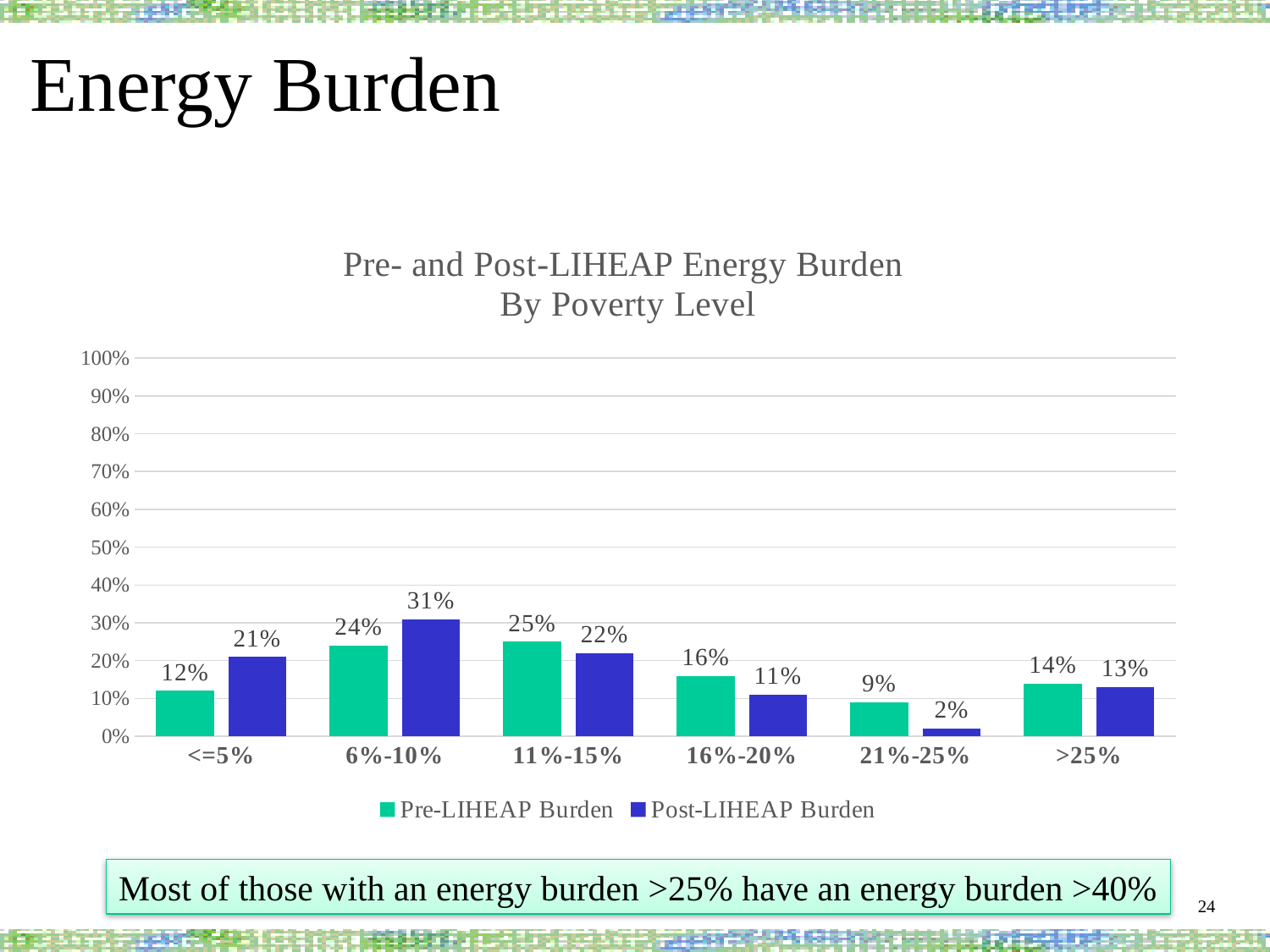
What is the Pre-LIHEAP Burden value for the <=5% category? 12% How many poverty level categories are shown on the x axis? 6 What colour are the Post-LIHEAP Burden bars? Blue Which is larger for the 16%-20% category, the Pre-LIHEAP Burden or the Post-LIHEAP Burden? Pre-LIHEAP Burden What kind of chart is shown on the slide? Bar chart What is the Post-LIHEAP Burden value for the 21%-25% category? 2% How many series does the legend list? 2 What is the title of the chart? Pre- and Post-LIHEAP Energy Burden By Poverty Level Which category has the lowest Post-LIHEAP Burden value? 21%-25% What is the difference between the Post-LIHEAP and Pre-LIHEAP Burden values for the <=5% category? 9% Which category has the highest Pre-LIHEAP Burden value? 11%-15% What is the Post-LIHEAP Burden value for the 6%-10% category? 31%